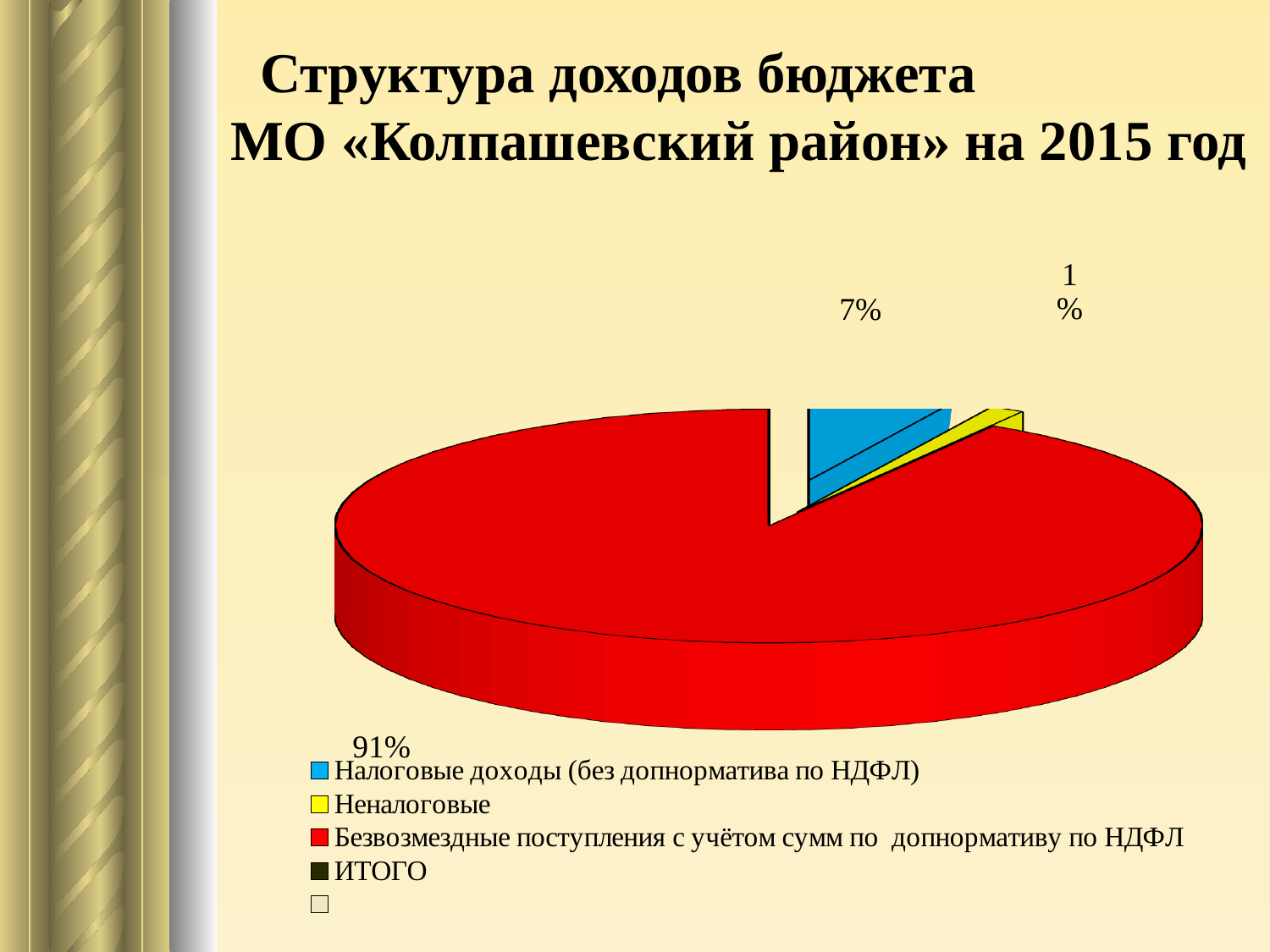
What share of the pie does Налоговые доходы (без допнорматива по НДФЛ) represent? 7% What share of the pie does Неналоговые represent? 1% What colour is the slice for Неналоговые? Yellow What share of the pie does Безвозмездные поступления с учётом сумм по допнормативу по НДФЛ represent? 91% How many slices are visible in the pie? 3 Which category has the smallest slice of the pie? Неналоговые What is the difference between the share of Безвозмездные поступления and the share of Налоговые доходы? 84% Which category has the largest slice of the pie? Безвозмездные поступления с учётом сумм по допнормативу по НДФЛ What kind of chart is shown on the slide? Pie chart What is the title of the slide? Структура доходов бюджета МО «Колпашевский район» на 2015 год Which is larger: the share of Налоговые доходы or the share of Неналоговые? Налоговые доходы What is the difference between the share of Налоговые доходы and the share of Неналоговые? 6%